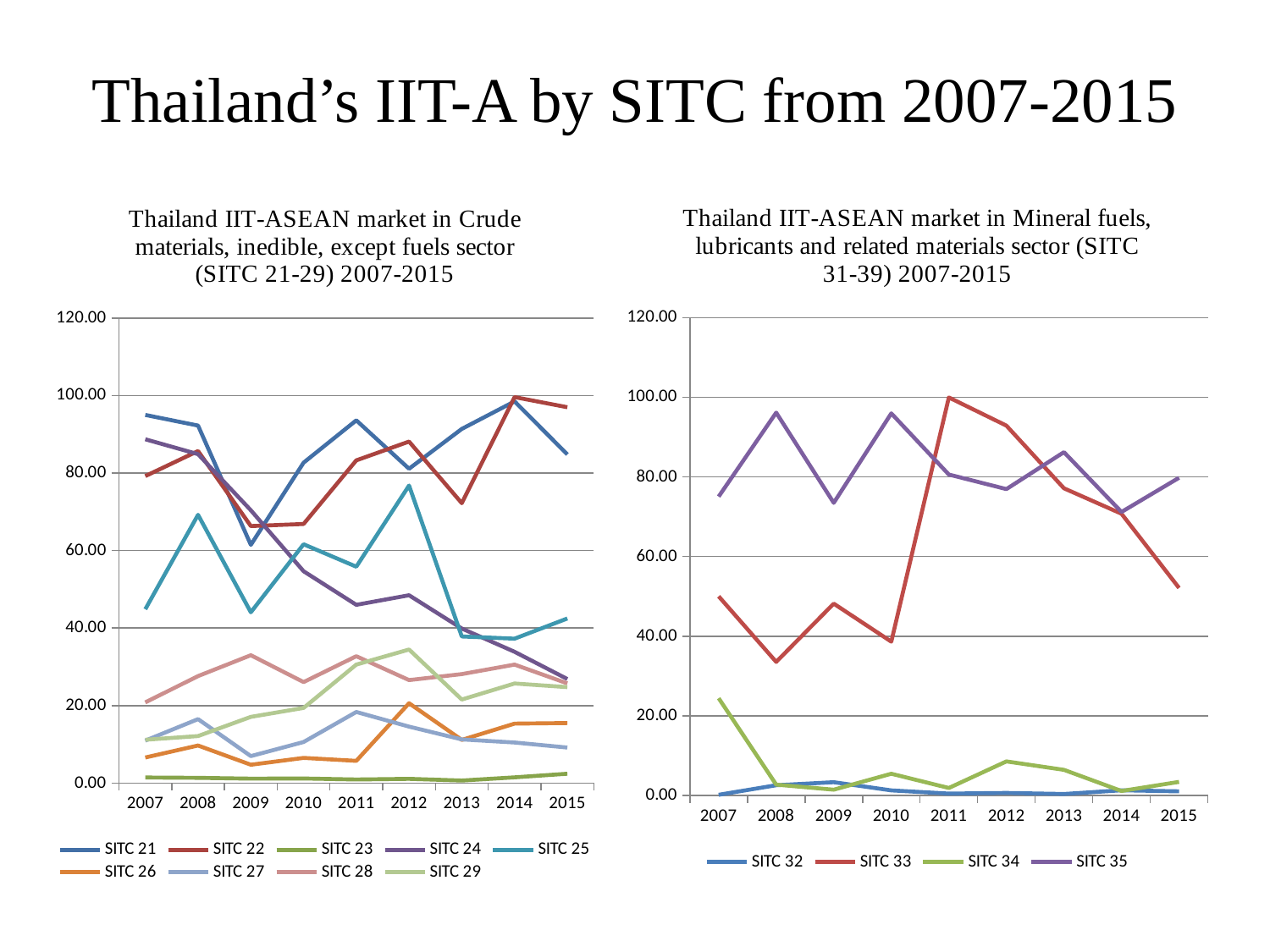
In the left chart (SITC 21-29), is the value for SITC 24 in 2015 greater or less than 40? less In the left chart (SITC 21-29), which series has the lowest value in 2012? SITC 23 In the right chart (SITC 31-39), which is larger in 2010: SITC 33 or SITC 35? SITC 35 How many years are shown on the x axis of the right chart (Mineral fuels, lubricants and related materials sector)? 9 What kind of chart is the left chart, 'Thailand IIT-ASEAN market in Crude materials, inedible, except fuels sector (SITC 21-29) 2007-2015'? Line chart In the right chart (SITC 31-39), which series has the highest value in 2008? SITC 35 In the left chart (SITC 21-29), is the value for SITC 21 in 2007 greater or less than 80? greater In the right chart (SITC 31-39), does the value for SITC 33 rise or fall from 2011 to 2015? fall How many series does the legend of the left chart (SITC 21-29) list? 9 In the right chart (SITC 31-39), is the value for SITC 35 in 2008 greater or less than 80? greater How many series does the legend of the right chart (SITC 31-39) list? 4